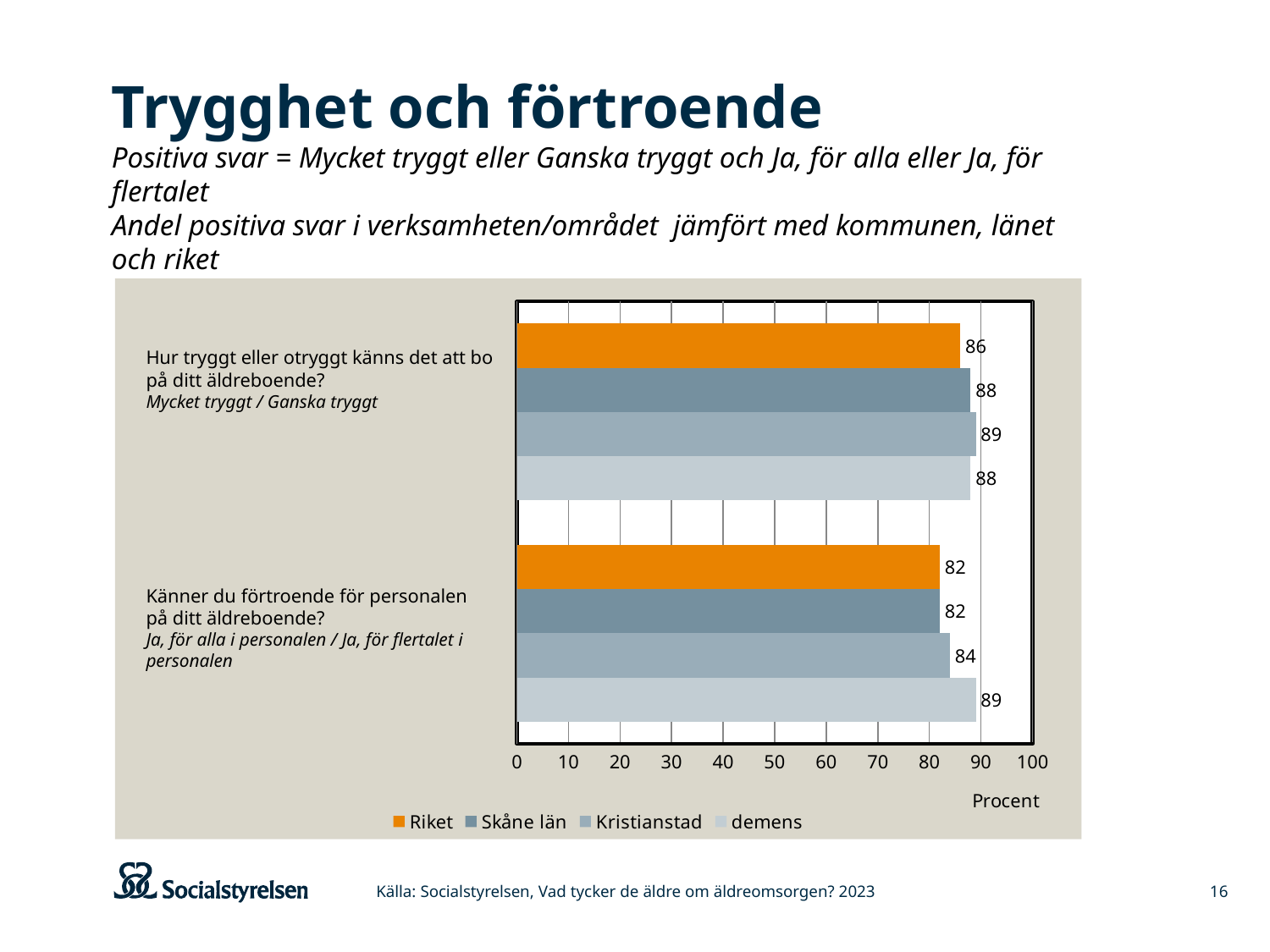
What is the difference between the demens value and the Riket value for the question "Känner du förtroende för personalen på ditt äldreboende?"? 7 What is the value for Skåne län for the question "Känner du förtroende för personalen på ditt äldreboende?"? 82 What kind of chart is shown on the slide? bar chart How many question categories are shown on the chart? 2 For the question "Känner du förtroende för personalen på ditt äldreboende?", which is larger: the value for Kristianstad or the value for demens? demens What is the value for demens for the question "Känner du förtroende för personalen på ditt äldreboende?"? 89 Which series has the highest value for the question "Känner du förtroende för personalen på ditt äldreboende?"? demens What is the value for Kristianstad for the question "Hur tryggt eller otryggt känns det att bo på ditt äldreboende?"? 89 How many series does the legend list? 4 Which series has the lowest value for the question "Hur tryggt eller otryggt känns det att bo på ditt äldreboende?"? Riket What label is shown on the horizontal axis of the chart? Procent What is the value for Riket for the question "Hur tryggt eller otryggt känns det att bo på ditt äldreboende?"? 86